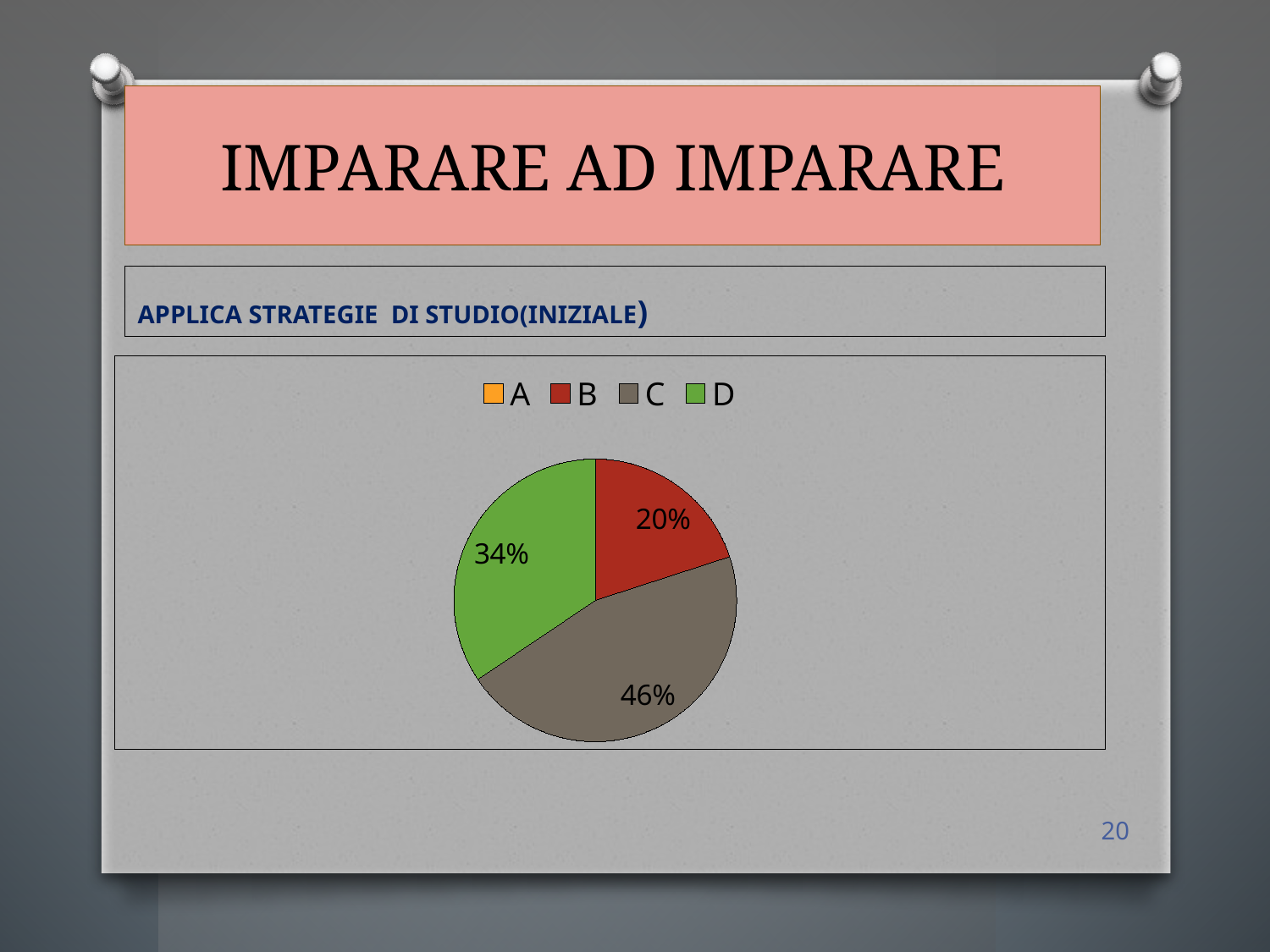
What colour is used for category D in the pie chart? green Which category has the largest slice of the pie chart? C What is the difference in percentage points between slice C and slice D? 12 What percentage is shown for slice D in the pie chart? 34% How many entries does the legend of the pie chart list? 4 Which slice is larger, C or D? C What percentage is shown for slice C in the pie chart? 46% What is the difference in percentage points between slice C and slice B? 26 Among the slices B, C and D, which has the smallest share? B What type of chart is shown on the slide? pie chart What is the title shown above the pie chart? APPLICA STRATEGIE DI STUDIO(INIZIALE) What percentage is shown for slice B in the pie chart? 20%